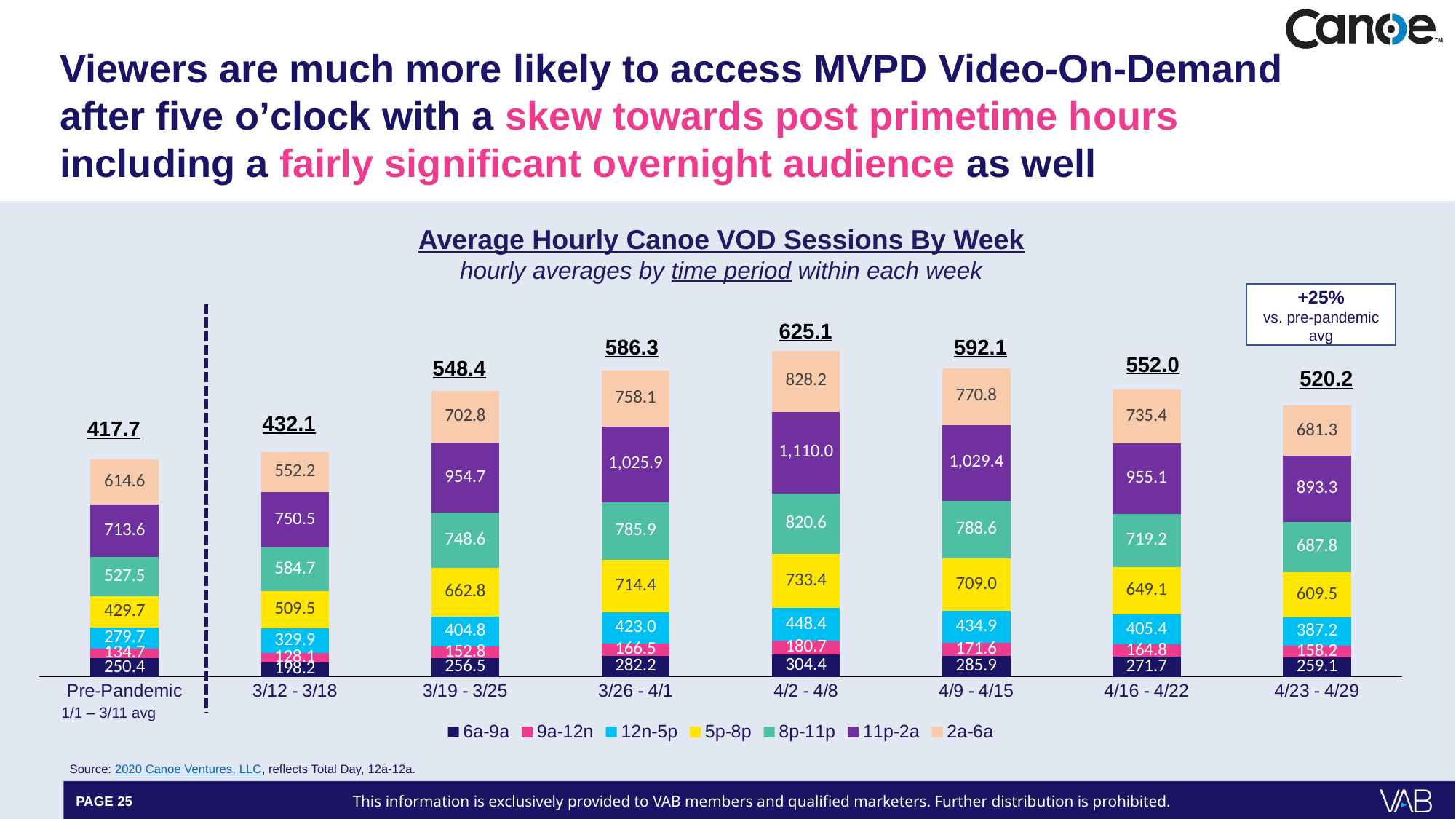
What kind of chart is shown on the slide? Stacked bar chart How many bars are shown in the chart? 8 What is the difference between the 11p-2a values for 4/9 - 4/15 and 4/16 - 4/22? 74.3 What is the value of the 11p-2a segment for the 4/2 - 4/8 week? 1,110.0 Which week has the highest average hourly value printed above its bar? 4/2 - 4/8 What average hourly value is printed above the 4/23 - 4/29 bar? 520.2 Which bar has the lowest average hourly value printed above it? Pre-Pandemic What is the value of the 6a-9a segment for the 3/12 - 3/18 week? 198.2 Which week has the larger 5p-8p value, 3/26 - 4/1 or 4/9 - 4/15? 3/26 - 4/1 What is the difference between the value printed above the 4/2 - 4/8 bar and the value printed above the Pre-Pandemic bar? 207.4 What is the value of the 2a-6a segment for the Pre-Pandemic bar? 614.6 How many time-period series does the legend list? 7